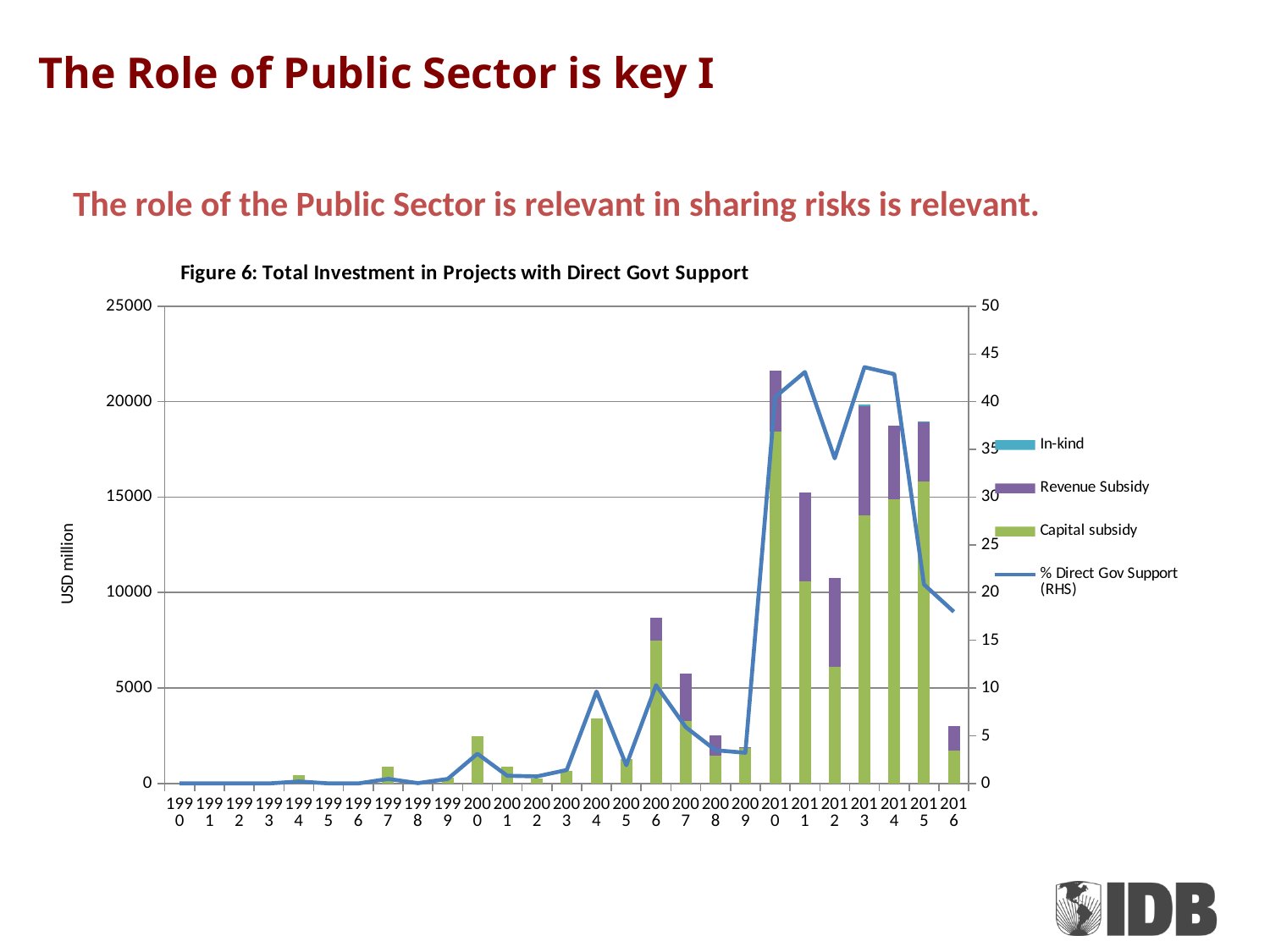
Is the total stacked bar for 2010 greater or less than 20000? greater Which year has the larger total stacked bar, 2006 or 2007? 2006 Is the total stacked bar for 2016 greater or less than 5000? less What kind of chart is shown in Figure 6? A stacked bar chart with a line What is the label of the left vertical axis in Figure 6? USD million Is the total stacked bar for 2006 greater or less than 5000? greater Which year has the tallest stacked bar in Figure 6? 2010 How many series does the legend of Figure 6 list? 4 How many years are shown on the x axis of Figure 6? 27 What is the title of the chart on the slide? Figure 6: Total Investment in Projects with Direct Govt Support Do the stacked bars generally rise or fall from 1990 to 2010? rise